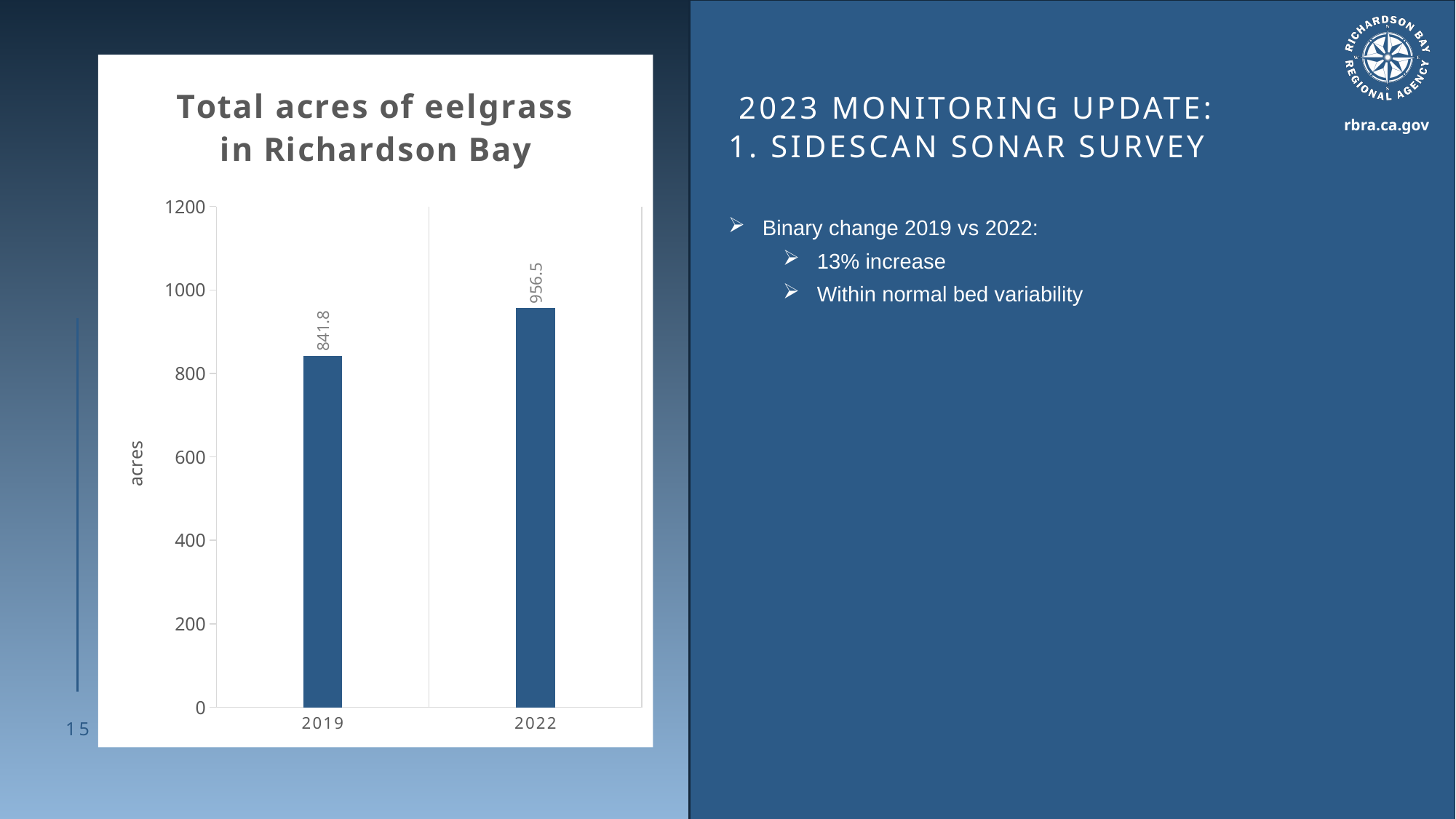
How many years are shown on the chart? 2 What kind of chart is shown? bar chart Is the value for 2022 greater or less than 800? greater Which year has the highest total acres of eelgrass? 2022 What is the value for 2022? 956.5 What is the difference between the 2022 and 2019 values? 114.7 What is the title of the chart? Total acres of eelgrass in Richardson Bay What is the value for 2019? 841.8 Which year has the lowest total acres of eelgrass? 2019 Is the value for 2019 greater or less than 1000? less Do the values rise or fall from 2019 to 2022? rise Which is larger, the value for 2019 or the value for 2022? 2022